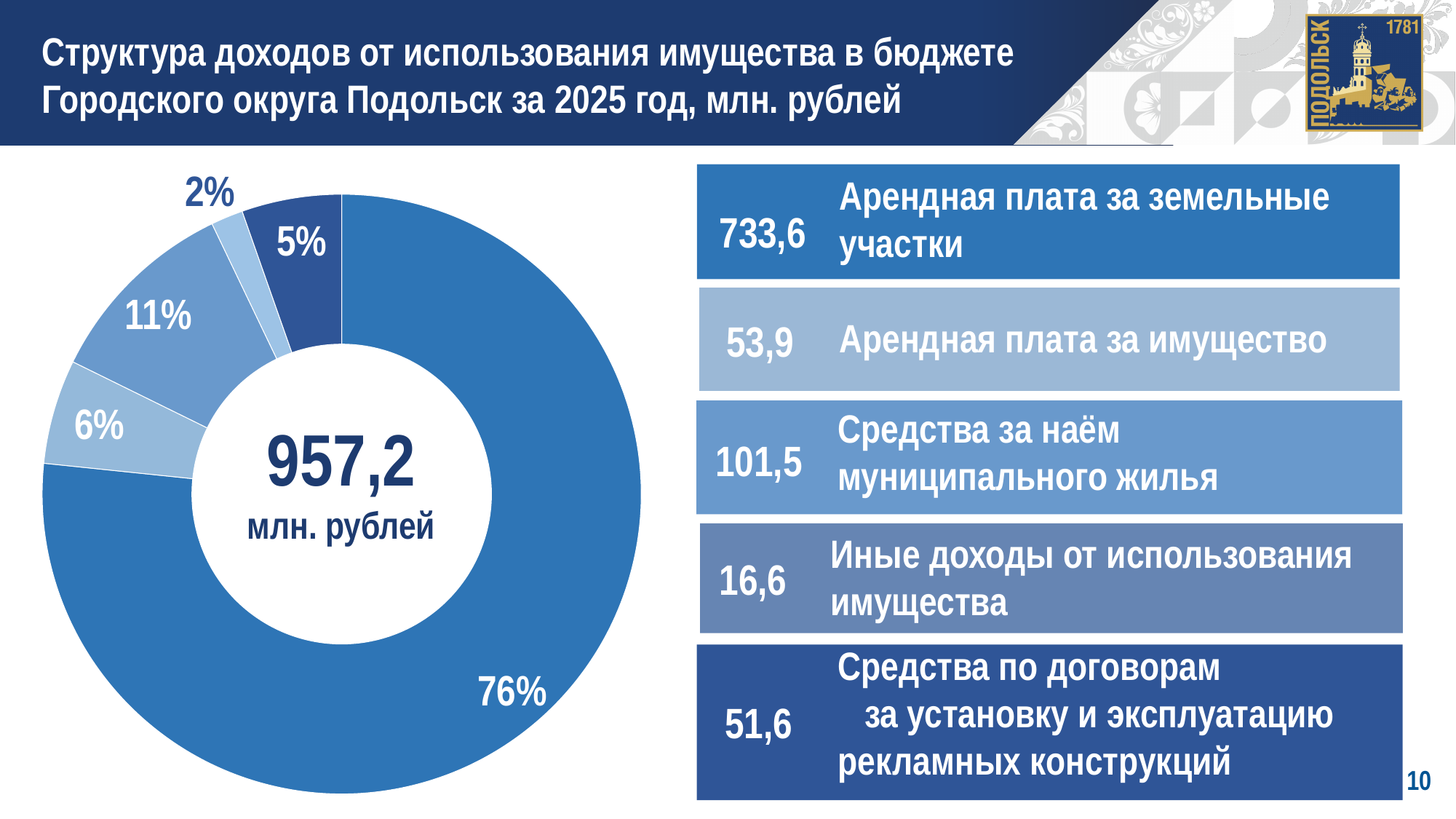
Что больше: арендная плата за имущество или средства по договорам за установку и эксплуатацию рекламных конструкций? Арендная плата за имущество Какое значение указано для категории «Арендная плата за земельные участки»? 733,6 Какая категория имеет наибольшую долю в структуре доходов? Арендная плата за земельные участки Сколько категорий доходов показано на диаграмме? 5 Какая общая сумма доходов от использования имущества указана в центре диаграммы? 957,2 млн. рублей На сколько млн. рублей арендная плата за имущество больше иных доходов от использования имущества? 37,3 Какое значение указано для категории «Иные доходы от использования имущества»? 16,6 Какая категория имеет наименьшую долю в структуре доходов? Иные доходы от использования имущества Какой тип диаграммы показан на слайде? Кольцевая (круговая) диаграмма Какую долю (в процентах) занимают средства за наём муниципального жилья? 11% Какую долю (в процентах) занимает арендная плата за земельные участки? 76% Какое значение указано для категории «Средства за наём муниципального жилья»? 101,5